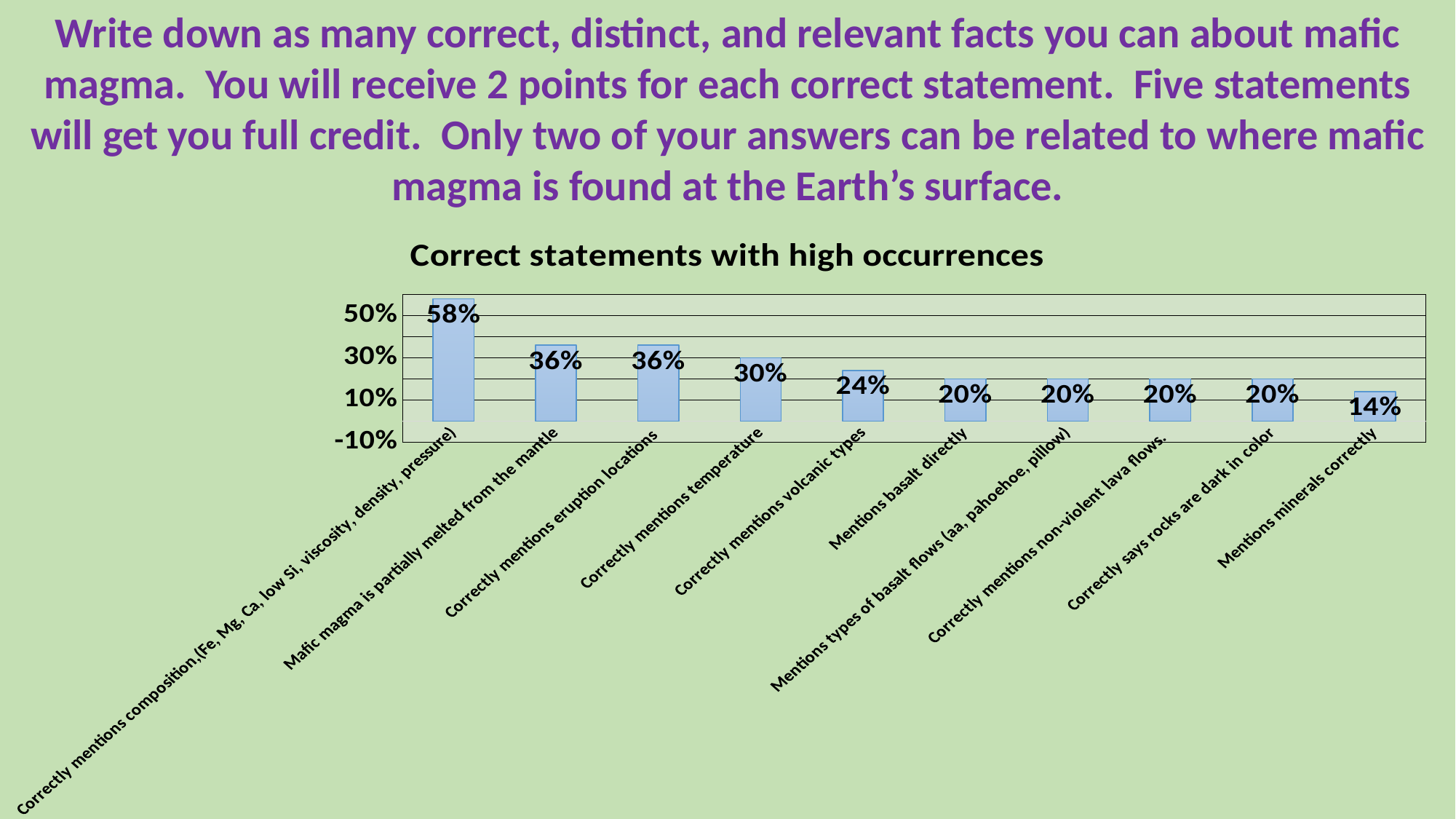
What is the title of the chart? Correct statements with high occurrences Do the values generally rise or fall from left to right along the x axis? Fall What is the value for "Mentions minerals correctly"? 14% How many categories are plotted in the chart? 10 Which category has the highest value? Correctly mentions composition,(Fe, Mg, Ca, low Si, viscosity, density, pressure) What is the difference between the highest value (58%) and the lowest value (14%)? 44 percentage points Which is larger: the value for "Correctly mentions temperature" or the value for "Mentions basalt directly"? Correctly mentions temperature What is the value for "Mafic magma is partially melted from the mantle"? 36% What kind of chart is shown on the slide? Bar chart Which category has the lowest value? Mentions minerals correctly What is the value for "Correctly mentions temperature"? 30% What is the value for "Correctly mentions volcanic types"? 24%